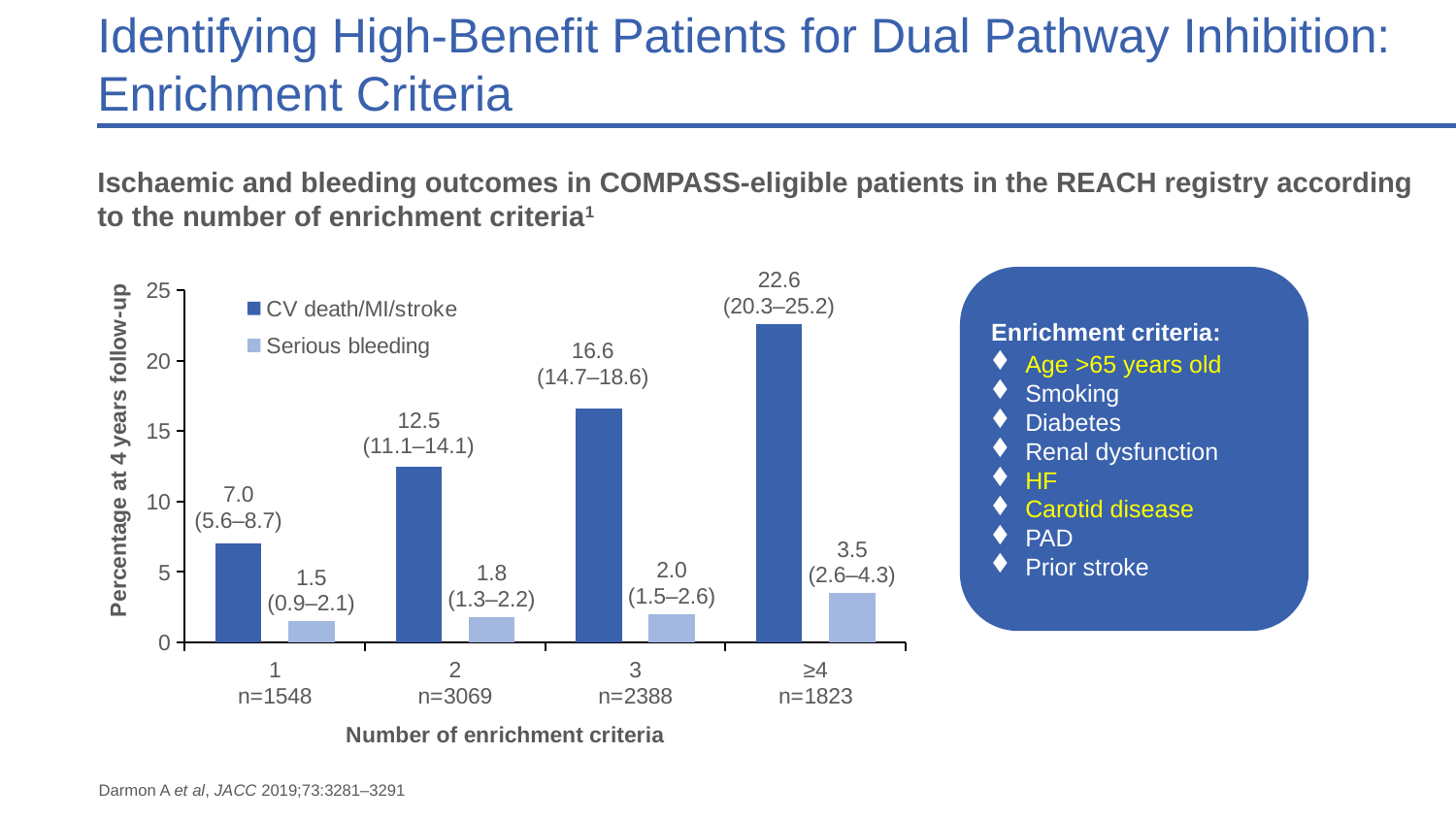
Which number of enrichment criteria has the highest CV death/MI/stroke percentage? ≥4 Which number of enrichment criteria has the lowest serious bleeding percentage? 1 What is the percentage for serious bleeding in patients with ≥4 enrichment criteria? 3.5 What is the percentage for CV death/MI/stroke in patients with 1 enrichment criterion? 7.0 Which is larger: the CV death/MI/stroke percentage for 2 enrichment criteria or for 3 enrichment criteria? 3 enrichment criteria What is the percentage for CV death/MI/stroke in patients with 3 enrichment criteria? 16.6 What is the difference between the CV death/MI/stroke percentages for ≥4 and 1 enrichment criteria? 15.6 How many series does the legend list? 2 How many enrichment criteria categories are shown on the x axis? 4 Does the CV death/MI/stroke percentage rise or fall as the number of enrichment criteria increases? Rises What kind of chart is shown on the slide? Bar chart What is the percentage for serious bleeding in patients with 2 enrichment criteria? 1.8